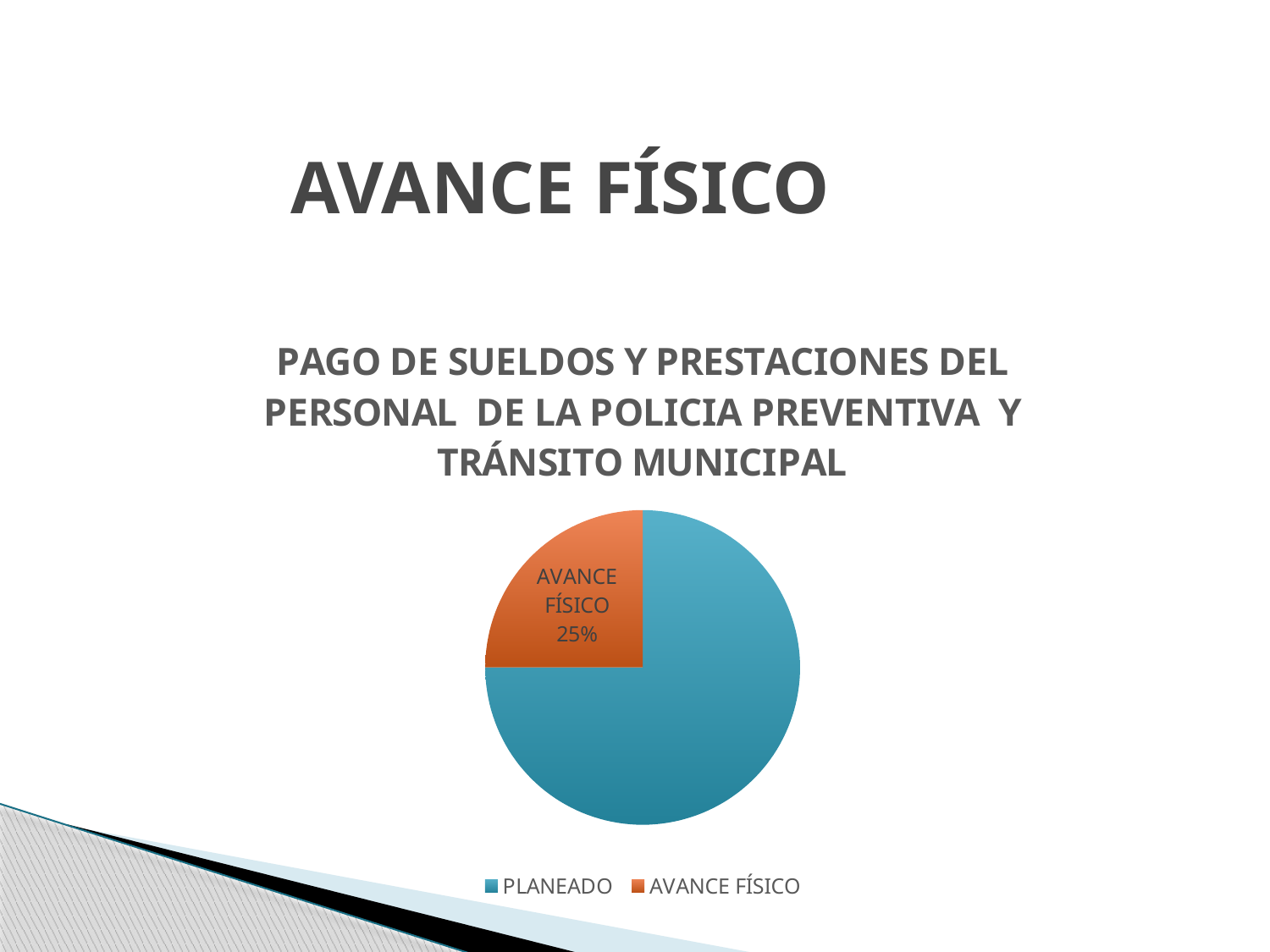
How many entries does the legend of the pie chart list? 2 How many slices does the pie chart have? 2 What percentage is shown for the AVANCE FÍSICO slice of the pie chart? 25% Which is larger in the pie chart, PLANEADO or AVANCE FÍSICO? PLANEADO What colour is the PLANEADO slice in the pie chart? blue Which slice of the pie chart is the smallest? AVANCE FÍSICO Which slice of the pie chart is the largest? PLANEADO What share of the pie does the AVANCE FÍSICO slice represent? 25% What colour is the AVANCE FÍSICO slice in the pie chart? orange What kind of chart is shown on the slide? pie chart